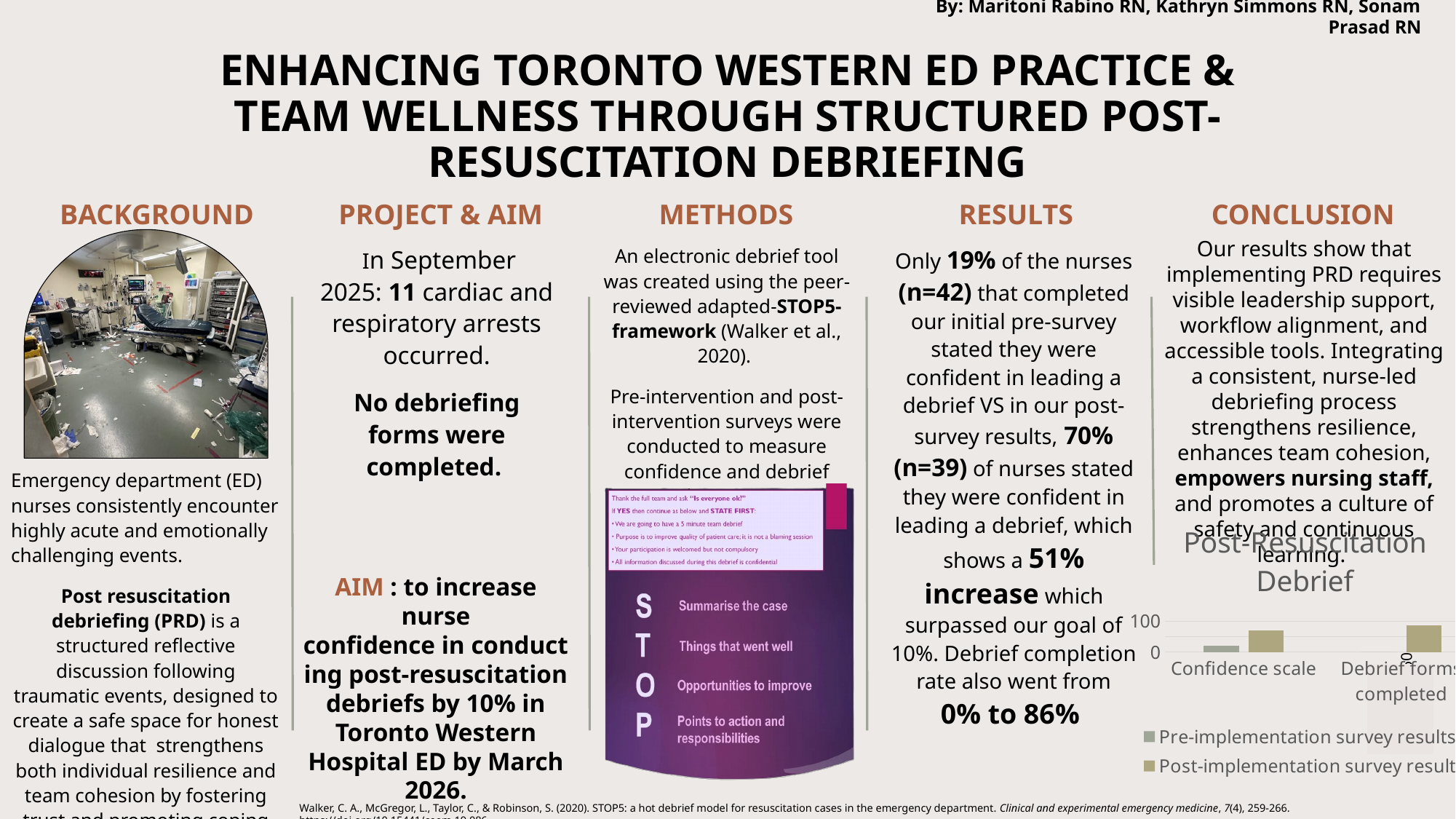
For Confidence scale, which is larger: the Pre-implementation or the Post-implementation survey result? Post-implementation survey results Is the Post-implementation survey results value for Debrief forms completed greater or less than 100? less What are the two series named in the chart's legend? Pre-implementation survey results and Post-implementation survey results How many series does the chart's legend list? 2 What type of chart is shown on the slide? bar chart How many categories are shown on the chart's x axis? 2 What is the title of the chart on the slide? Post-Resuscitation Debrief In the chart, which bar is the lowest? Pre-implementation survey results for Debrief forms completed What is the Pre-implementation survey results value for Debrief forms completed in the chart? 0 For Debrief forms completed, which is larger: the Pre-implementation or the Post-implementation survey result? Post-implementation survey results Is the Pre-implementation survey results value for Confidence scale greater or less than 100? less In the chart, which bar is the tallest? Post-implementation survey results for Debrief forms completed